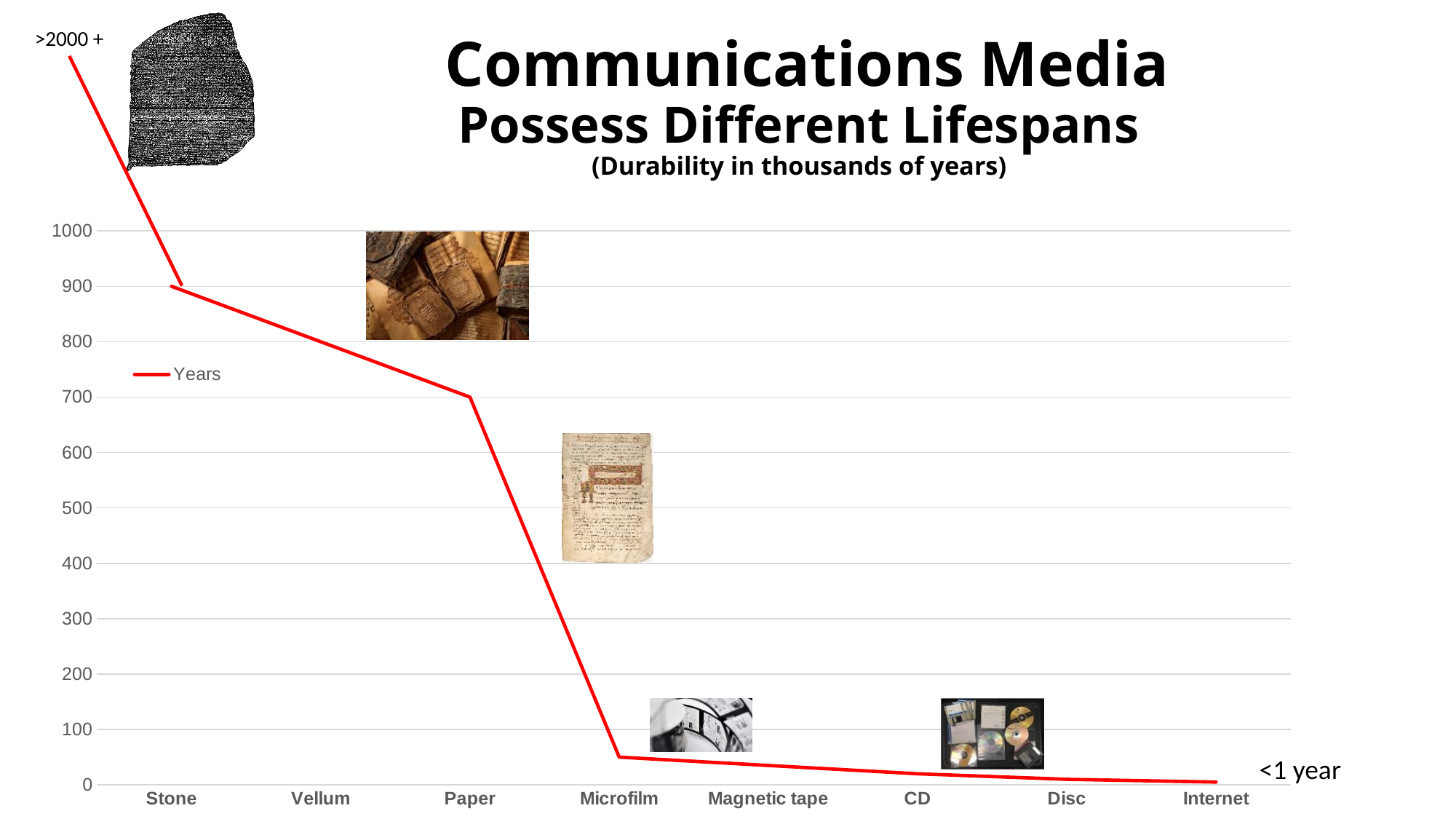
Which labelled medium has the lowest durability value on the chart? Internet What is the value plotted for Stone? 900 Is the value for Paper greater or less than 600? greater Is the value for Vellum greater or less than 900? less Which labelled medium has the highest durability value on the chart? Stone Which has the larger value, Paper or Microfilm? Paper How many categories are labelled on the x axis of the chart? 8 How many series does the chart's legend list? 1 What is the name of the series shown in the legend? Years What kind of chart is shown on the slide? line chart Is the value for Microfilm greater or less than 100? less Do the values rise or fall moving from Stone to Internet along the x axis? fall